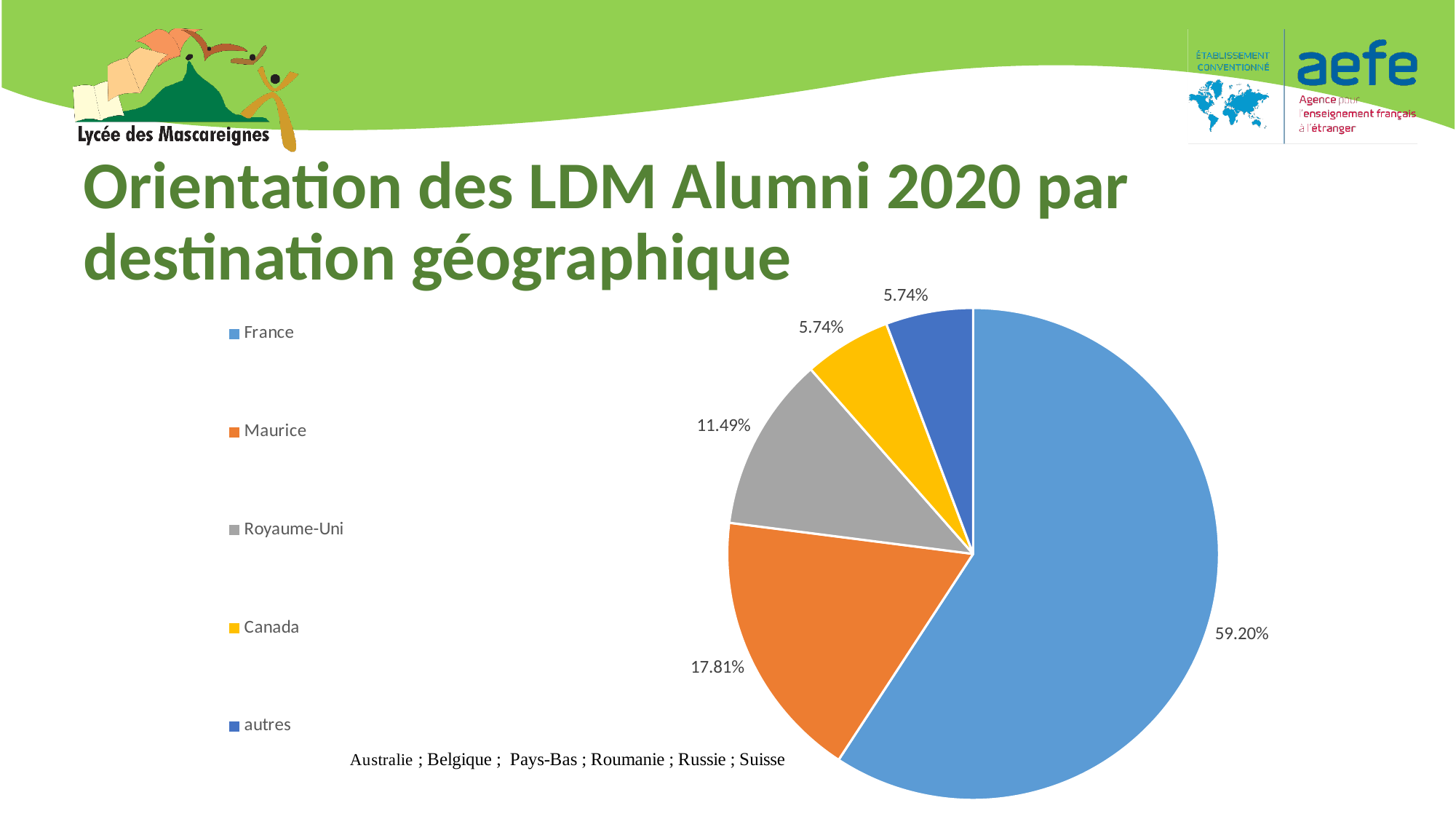
What kind of chart is shown on the slide? pie chart What is the value shown for Maurice? 17.81% Which destination has the largest share of the pie? France What is the title of the slide containing the chart? Orientation des LDM Alumni 2020 par destination géographique Which is larger, the share for Maurice or the share for Royaume-Uni? Maurice How many slices does the pie chart have? 5 What is the difference between the shares of France and Maurice? 41.39% What is the value shown for Canada? 5.74% What is the value shown for Royaume-Uni? 11.49% What is the combined share of France and Maurice? 77.01% What is the value shown for the 'autres' slice? 5.74% What share of the pie does France represent? 59.20%